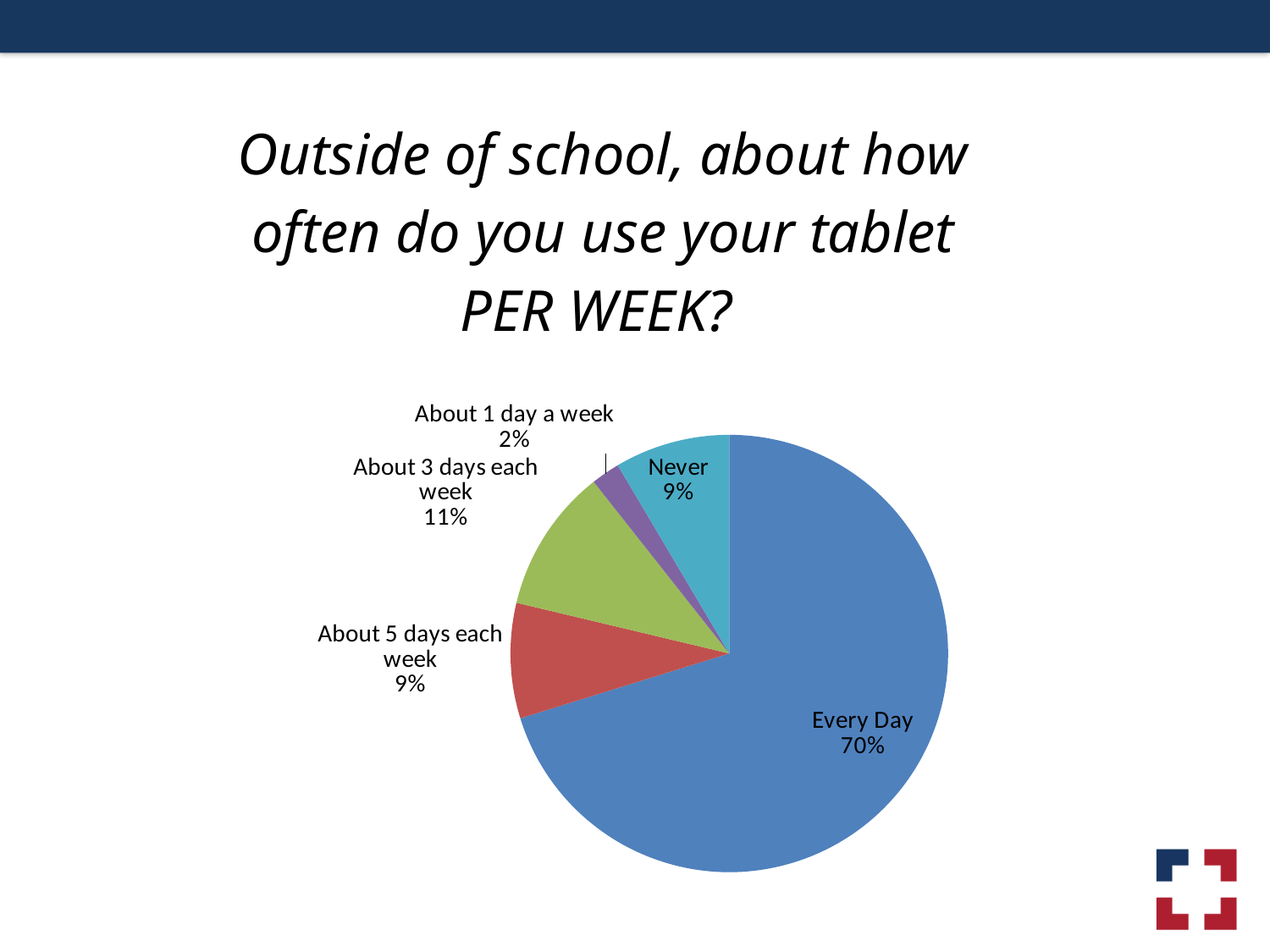
What percentage of respondents use their tablet every day outside of school? 70% What is the difference in percentage points between 'Every Day' and 'About 3 days each week'? 59 Which category has the smallest slice of the pie? About 1 day a week What share of the pie is labelled 'Never'? 9% What percentage is shown for 'About 3 days each week'? 11% What kind of chart is shown on the slide? pie chart How many slices does the pie chart have? 5 Which is larger, the slice for 'About 3 days each week' or the slice for 'About 1 day a week'? About 3 days each week What colour is the 'Every Day' slice? blue What percentage is shown for 'About 1 day a week'? 2% What percentage is shown for 'About 5 days each week'? 9% Which category has the largest slice of the pie? Every Day